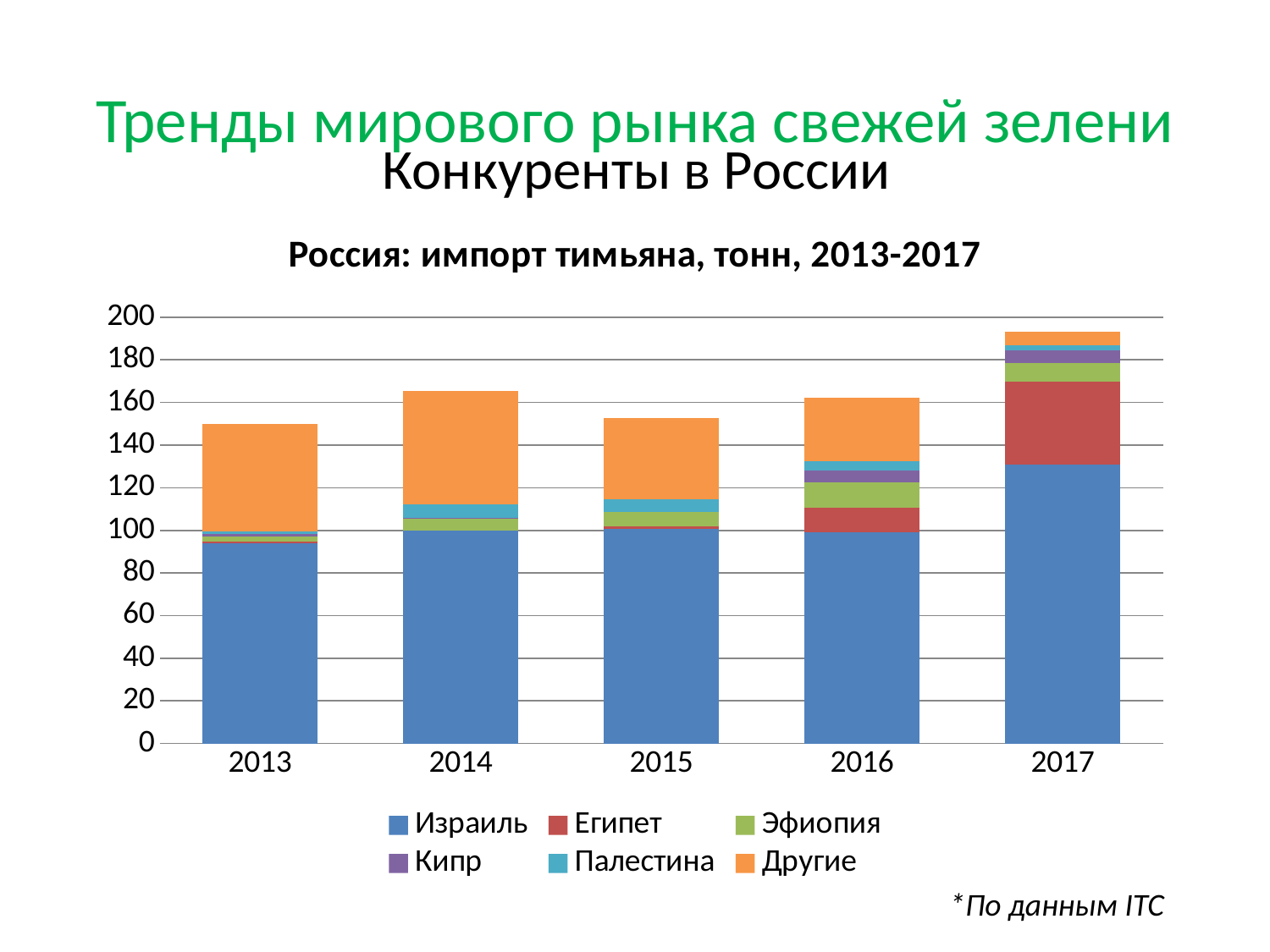
Which year has the highest total import of thyme? 2017 Is the total for 2013 greater or less than 160? less Is the Израиль segment in 2013 greater or less than 100? less Which series is shown in orange in the legend? Другие Does the total import rise or fall from 2016 to 2017? rise What is the title of the chart? Россия: импорт тимьяна, тонн, 2013-2017 Is the total for 2017 greater or less than 180? greater Which is larger, the total for 2017 or the total for 2013? 2017 How many years are shown on the x axis? 5 What kind of chart is shown on the slide? Stacked bar chart How many series does the legend list? 6